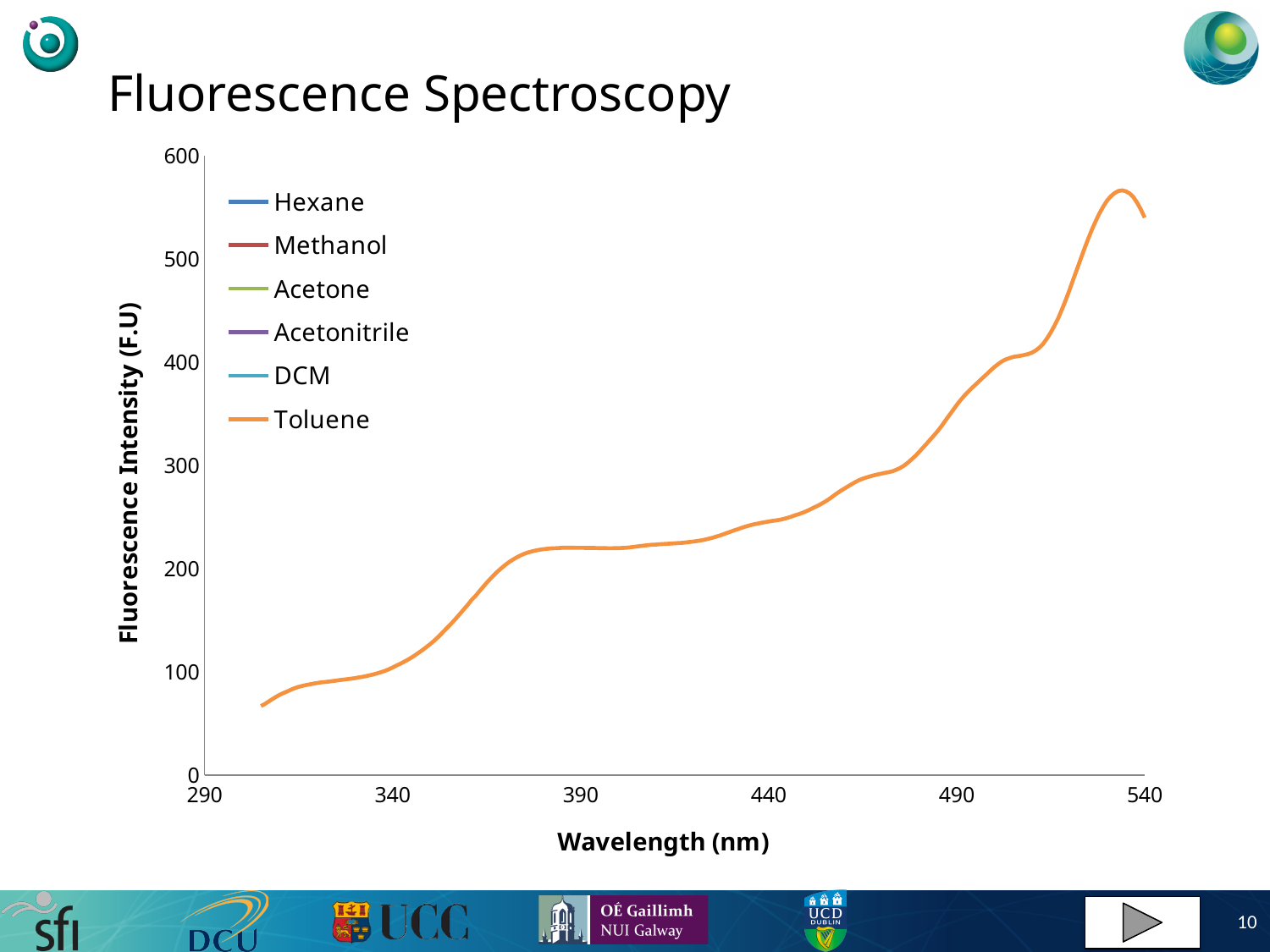
Does the Toluene line generally rise or fall as wavelength increases from 290 nm to 540 nm? rise Is the Toluene value at 390 nm greater or less than 200? greater How many series does the legend list? 6 Is the Toluene value at 440 nm greater or less than 300? less Is the Toluene value at 490 nm greater or less than 300? greater What is the label of the x axis? Wavelength (nm) What kind of chart is shown on the slide? line chart What is the title of the slide's chart? Fluorescence Spectroscopy